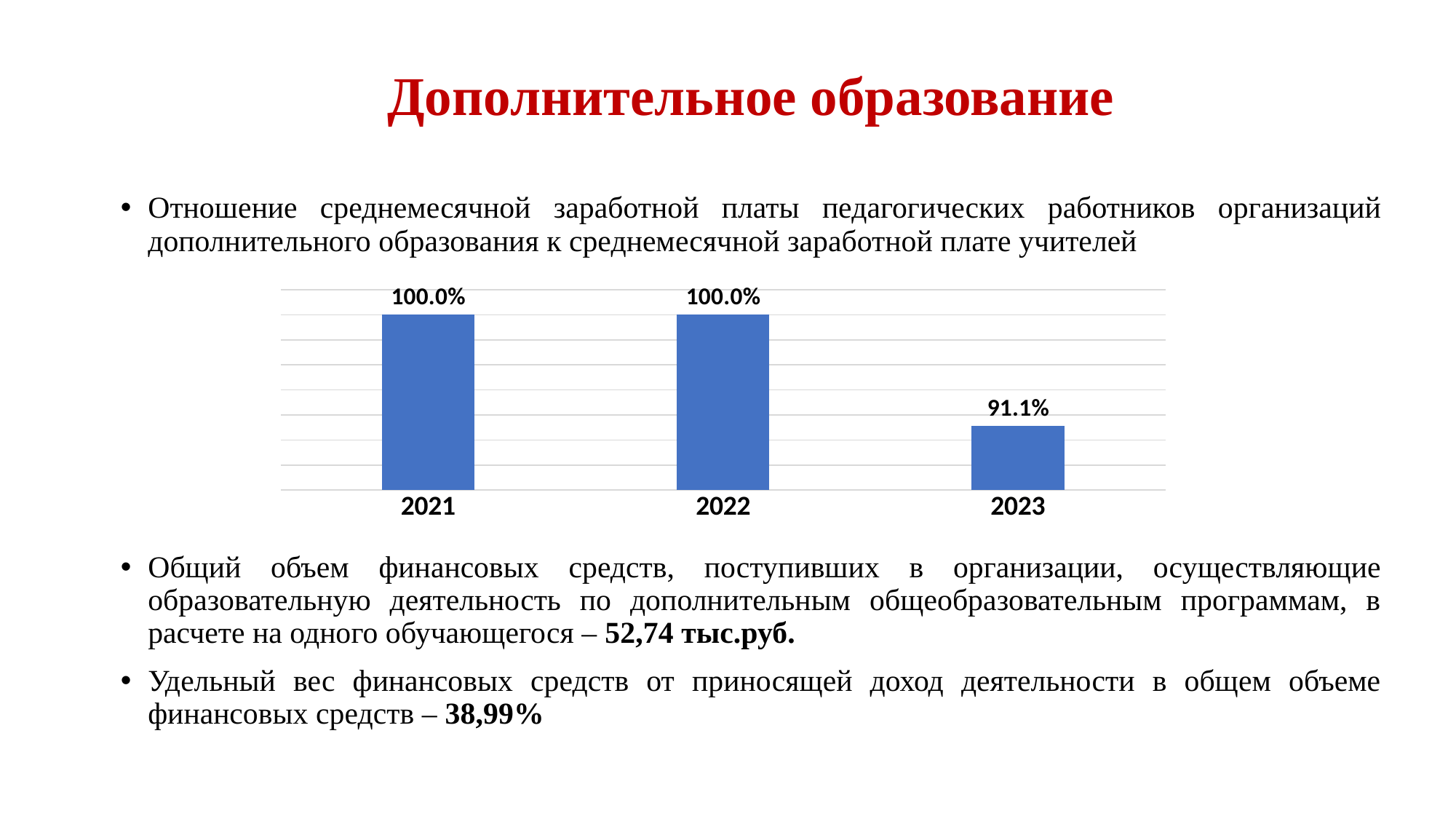
Are the values for 2021 and 2022 equal? yes What is the value for 2023? 91.1% What is the value for 2021? 100.0% What is the value for 2022? 100.0% What kind of chart is shown on the slide? bar chart Which year has the lowest value? 2023 Which years have a value of 100.0%? 2021 and 2022 What colour are the bars on the chart? blue How many years are shown on the chart? 3 What is the difference between the values for 2022 and 2023? 8.9% Which is larger, the value for 2021 or the value for 2023? 2021 Do the values rise or fall from 2022 to 2023? fall